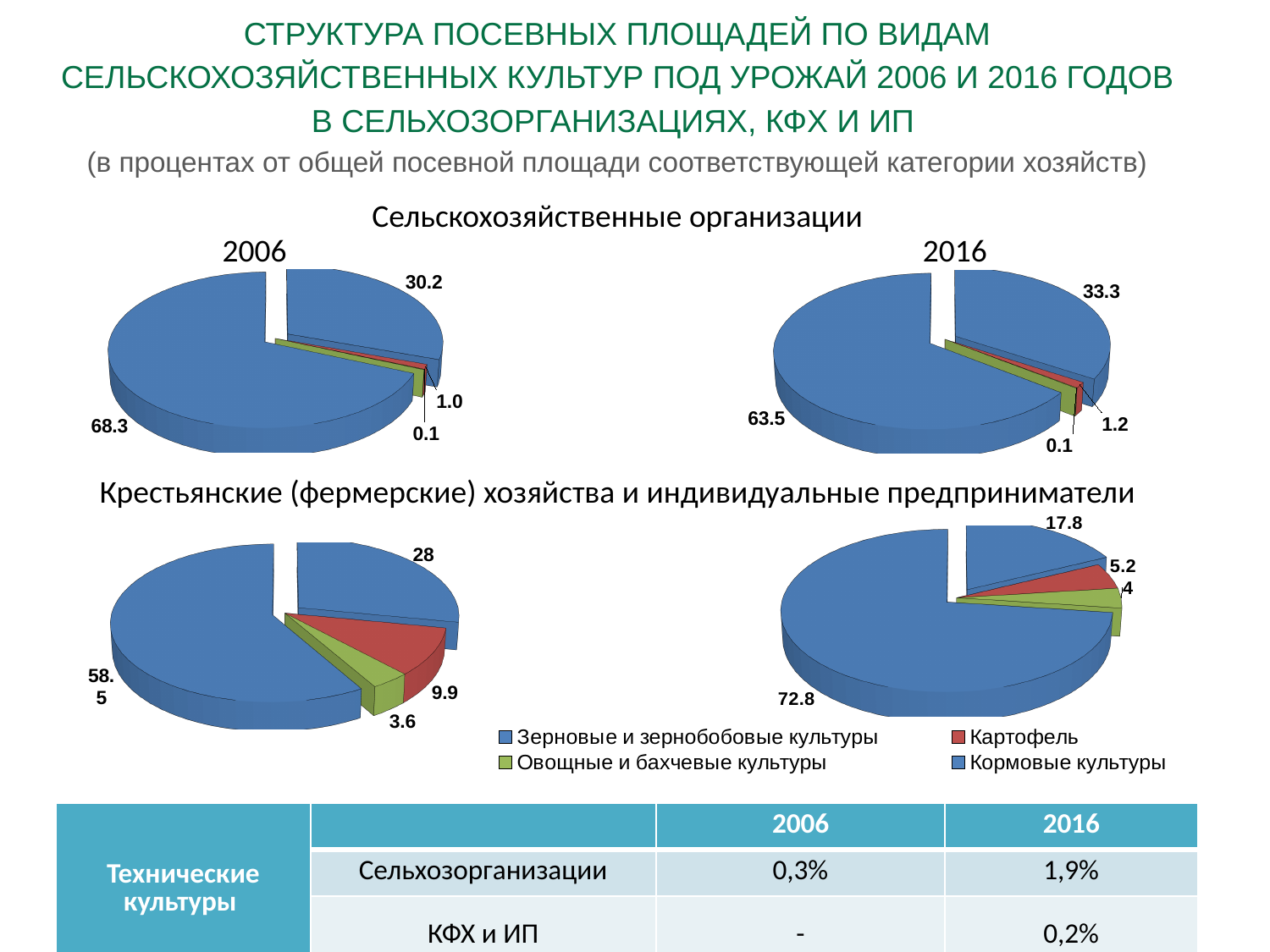
In the 2016 pie chart for "Крестьянские (фермерские) хозяйства и индивидуальные предприниматели", what value is shown for the red slice (Картофель)? 5.2 In the 2006 pie chart for "Крестьянские (фермерские) хозяйства и индивидуальные предприниматели", what value is shown for the green slice (Овощные и бахчевые культуры)? 3.6 In the 2016 pie chart for "Сельскохозяйственные организации", what value is shown for the largest slice? 63.5 In the 2016 pie chart for "Сельскохозяйственные организации", what is the value of the smallest slice? 0.1 For "Сельскохозяйственные организации", is the largest slice value bigger in the 2006 pie or the 2016 pie? 2006 How many slices does each pie chart on the slide have? 4 How many entries does the legend below the pie charts list? 4 What type of chart is used to show the crop structure on this slide? Pie chart For "Крестьянские (фермерские) хозяйства и индивидуальные предприниматели", by how much did the Картофель (red) slice value decrease from 2006 (9.9) to 2016 (5.2)? 4.7 In the 2016 pie chart for "Крестьянские (фермерские) хозяйства и индивидуальные предприниматели", what is the value of the largest slice? 72.8 For "Сельскохозяйственные организации", what is the difference between the Картофель (red) slice values in 2016 (1.2) and 2006 (1.0)? 0.2 In the 2006 pie chart for "Сельскохозяйственные организации", what value is shown for the red slice (Картофель)? 1.0